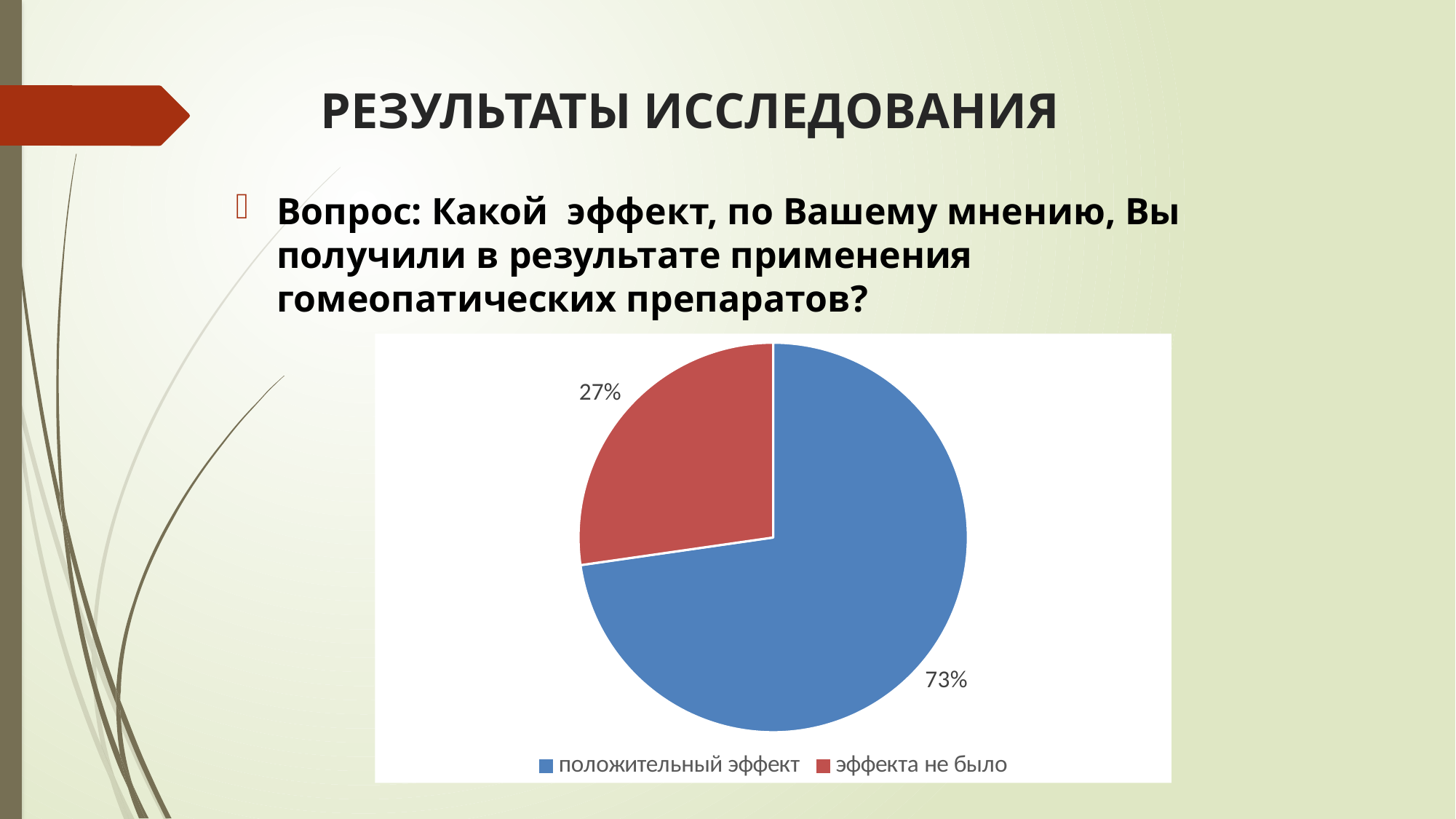
Which category has the largest slice of the pie? положительный эффект Which is larger: the slice for "положительный эффект" or the slice for "эффекта не было"? положительный эффект Which category has the smallest slice of the pie? эффекта не было What colour is the slice for "положительный эффект"? blue What share of the pie does "эффекта не было" take? 27% What share of the pie does "положительный эффект" take? 73% What is the difference in percentage points between the "положительный эффект" slice and the "эффекта не было" slice? 46 What colour is the slice for "эффекта не было"? red How many entries does the legend list? 2 What kind of chart is shown on the slide? pie chart How many slices does the pie chart have? 2